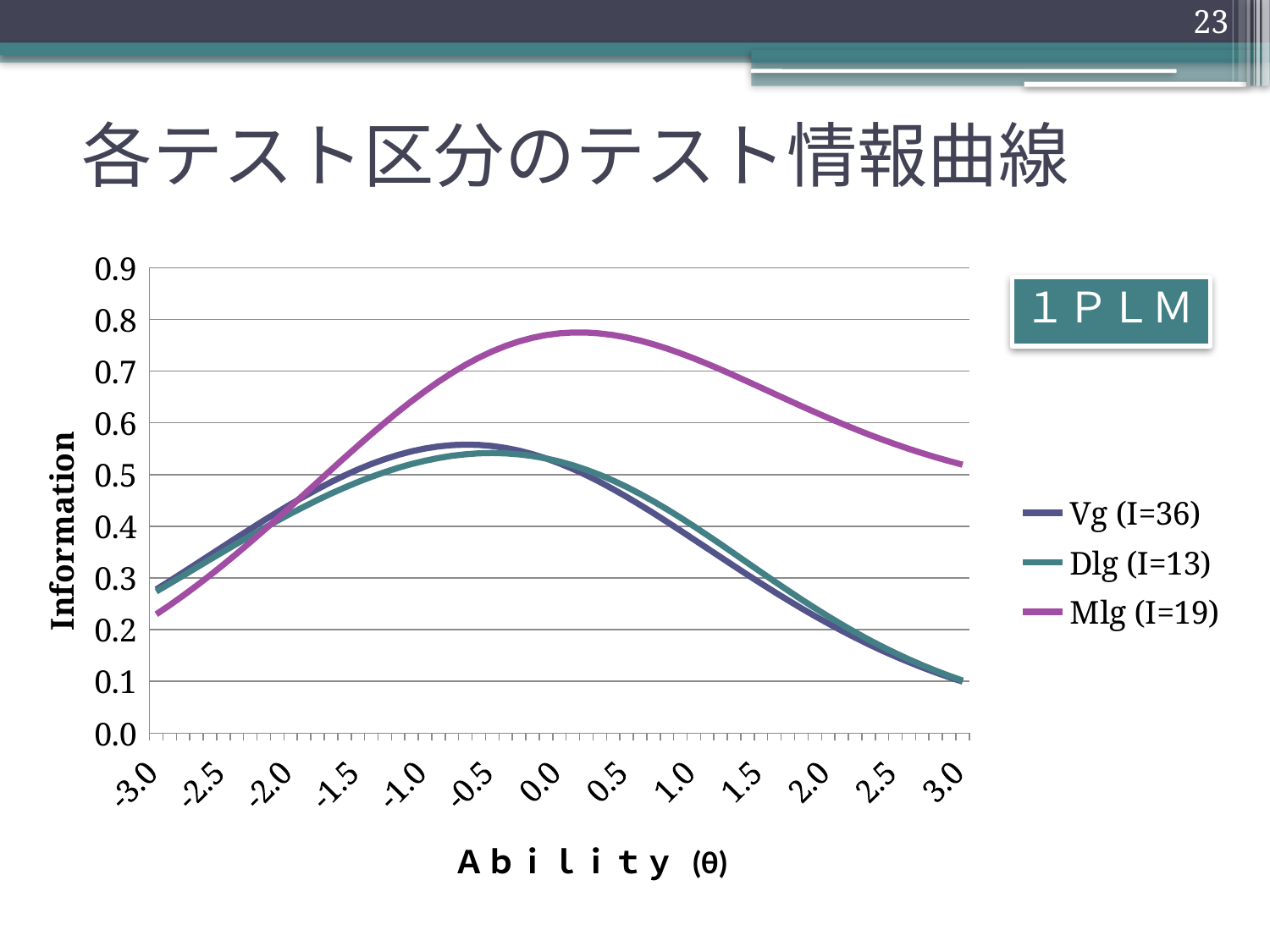
Does the Mlg (I=19) line rise or fall as Ability goes from 0.5 to 3.0? fall Is the value for Vg (I=36) at Ability 3.0 greater or less than 0.2? less Is the value for Mlg (I=19) at Ability -3.0 greater or less than 0.3? less Which series reaches the highest peak value of Information? Mlg (I=19) What is the label on the vertical axis? Information At Ability 3.0, which series has the larger value, Mlg (I=19) or Vg (I=36)? Mlg (I=19) How many series does the legend list? 3 Is the value for Mlg (I=19) at Ability 3.0 greater or less than 0.4? greater What kind of chart is shown on the slide? line chart Which legend entry corresponds to the purple line? Mlg (I=19) At Ability -3.0, which series has the larger value, Vg (I=36) or Mlg (I=19)? Vg (I=36)